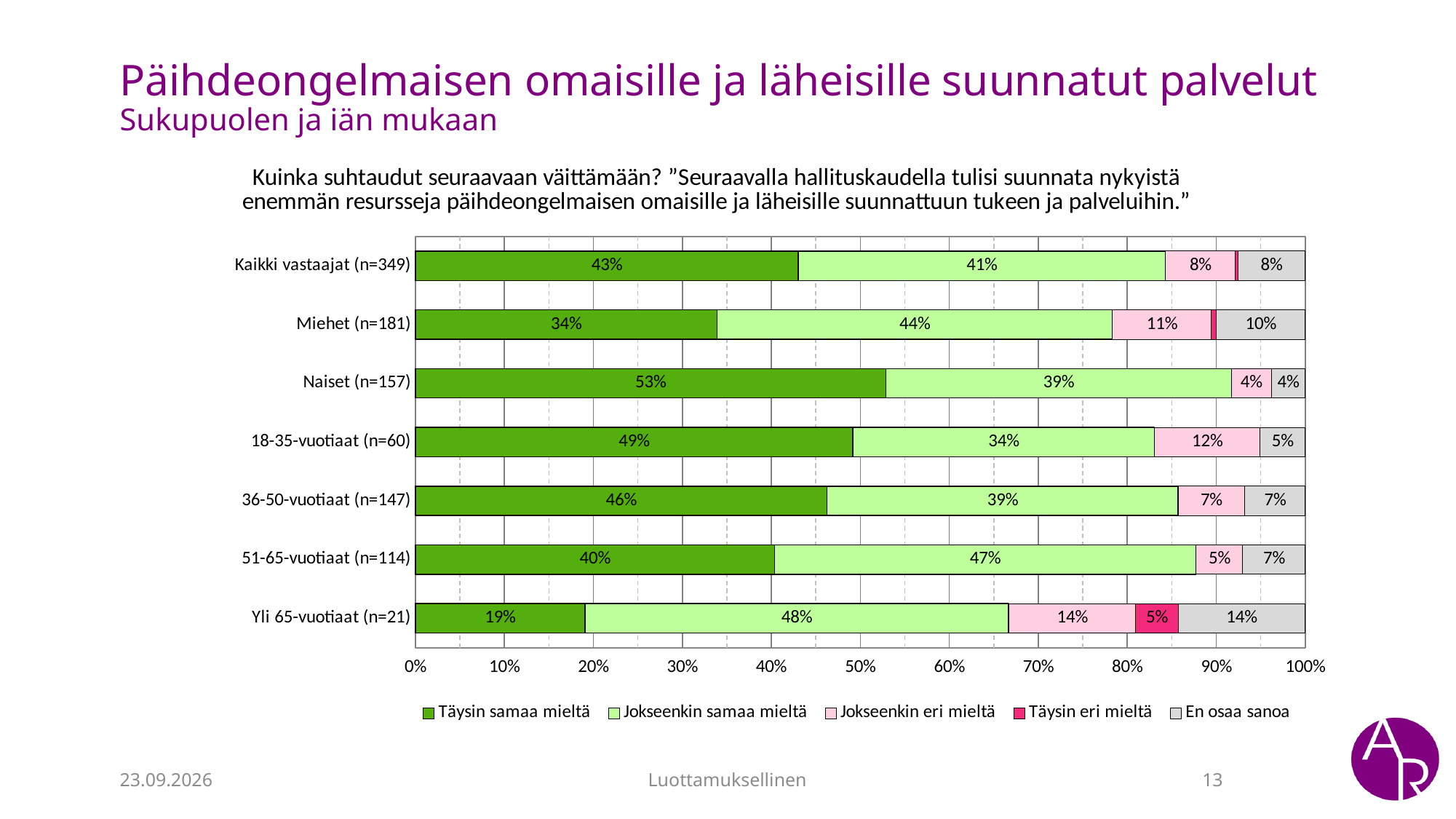
Which category has the highest "Täysin samaa mieltä" share? Naiset (n=157) What kind of chart is shown on the slide? Stacked bar chart What is the "En osaa sanoa" value for Yli 65-vuotiaat (n=21)? 14% How many percentage points higher is the "Täysin samaa mieltä" share for Naiset (n=157) than for Miehet (n=181)? 19 percentage points What is the "Jokseenkin eri mieltä" value for Miehet (n=181)? 11% Which has a larger "Jokseenkin samaa mieltä" share: 18-35-vuotiaat (n=60) or 36-50-vuotiaat (n=147)? 36-50-vuotiaat (n=147) Which category has the lowest "Täysin samaa mieltä" share? Yli 65-vuotiaat (n=21) What is the "Jokseenkin samaa mieltä" value for 51-65-vuotiaat (n=114)? 47% Which legend entry is shown in dark green? Täysin samaa mieltä What percentage of Naiset (n=157) answered "Täysin samaa mieltä"? 53% How many respondent categories are shown on the chart? 7 How many series does the legend list? 5